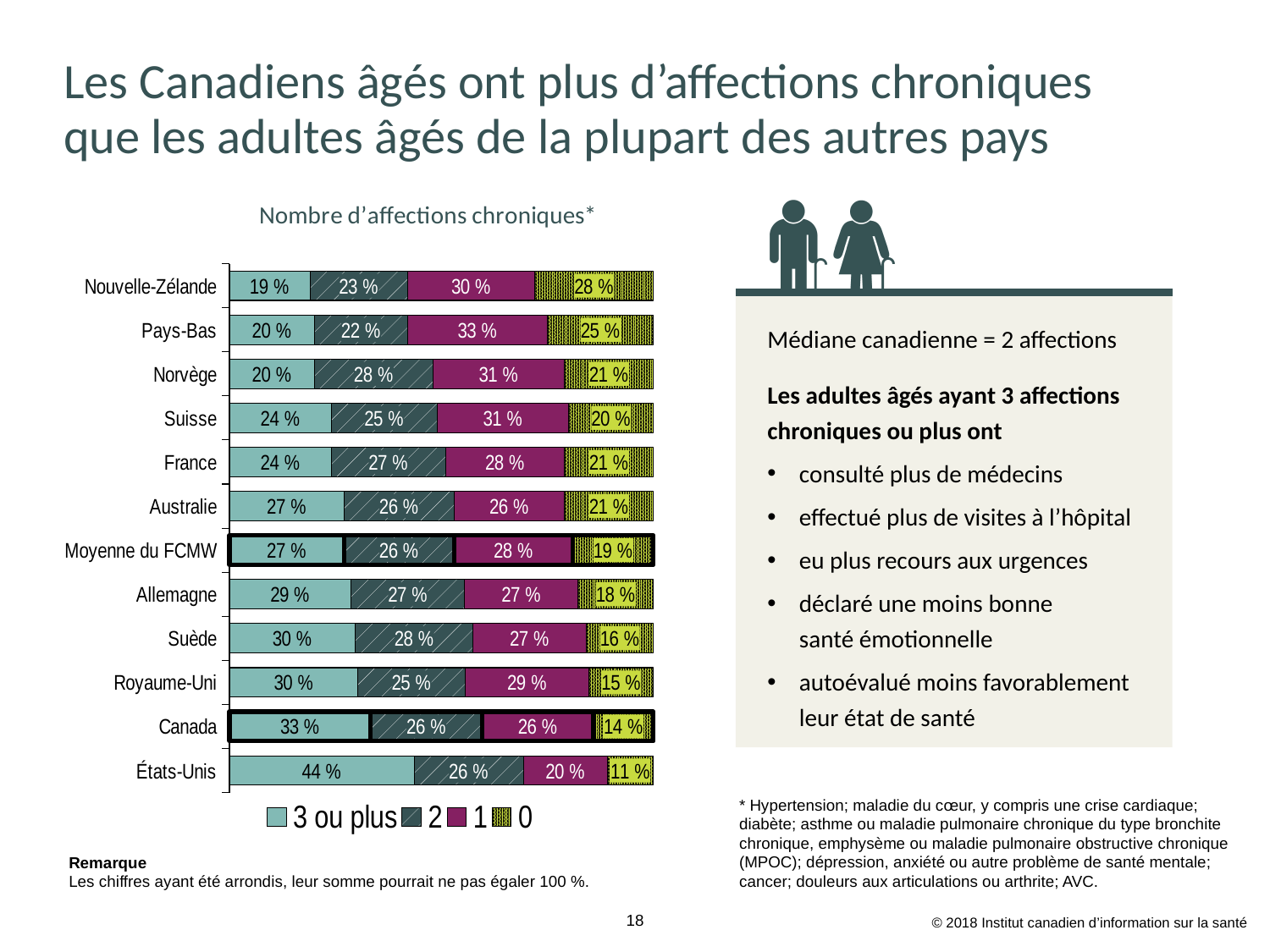
Which category has the lowest value in the "0" series? États-Unis In the "2" series, which is larger: Suède or Royaume-Uni? Suède How many categories are shown on the y axis of the chart? 12 How many series does the legend list? 4 What is the difference between the "3 ou plus" values for Canada and Moyenne du FCMW? 6 % What is the value for Canada in the "3 ou plus" series? 33 % What is the value for Nouvelle-Zélande in the "0" series? 28 % Which country has the highest value in the "3 ou plus" series? États-Unis What is the value for États-Unis in the "3 ou plus" series? 44 % Which category has the lowest value in the "3 ou plus" series? Nouvelle-Zélande What is the title of the chart? Nombre d’affections chroniques* What kind of chart is shown on the slide? Stacked bar chart